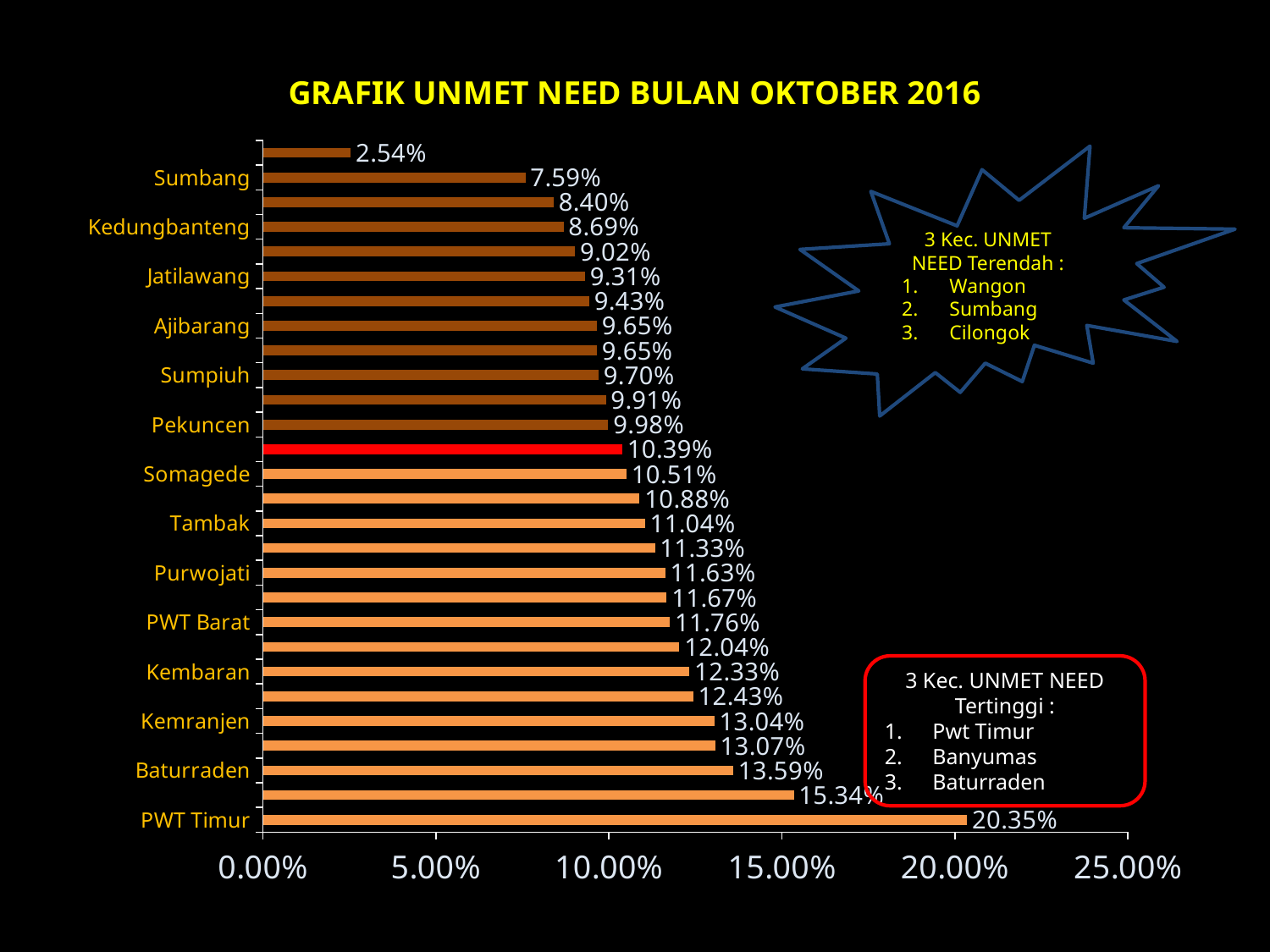
What is the difference between the values for PWT Timur and Baturraden? 6.76% What kind of chart is shown? bar chart What is the value for Baturraden? 13.59% What is the value for PWT Timur? 20.35% Which category has the highest value? PWT Timur What is the smallest value shown on the chart? 2.54% Which is larger, the value for Kembaran or the value for Tambak? Kembaran How many bars are plotted on the chart? 28 Is the value for Sumpiuh greater or less than 10.00%? less What is the value for Kedungbanteng? 8.69% What is the title of the chart? GRAFIK UNMET NEED BULAN OKTOBER 2016 What is the value for Sumbang? 7.59%